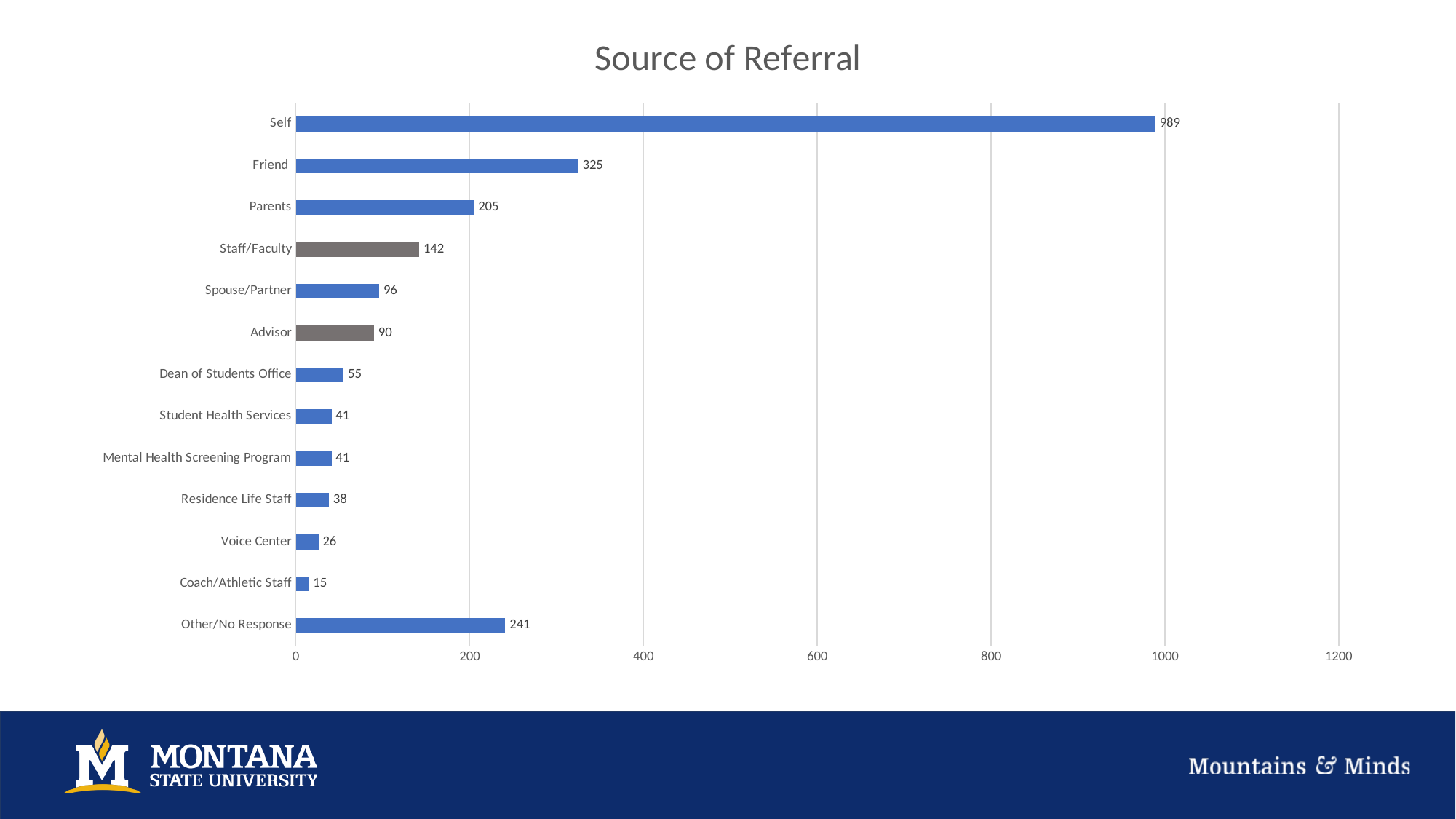
Which source of referral has the highest value? Self What is the difference between the values for Self and Friend? 664 What is the value for Staff/Faculty? 142 How many categories are shown in the chart? 13 What is the title of the chart? Source of Referral Which is larger, the value for Spouse/Partner or the value for Advisor? Spouse/Partner Which source of referral has the lowest value? Coach/Athletic Staff What is the difference between the values for Parents and Staff/Faculty? 63 What is the value for Other/No Response? 241 What is the value for Self in the Source of Referral chart? 989 What is the value for Friend? 325 What kind of chart is shown on the slide? Bar chart